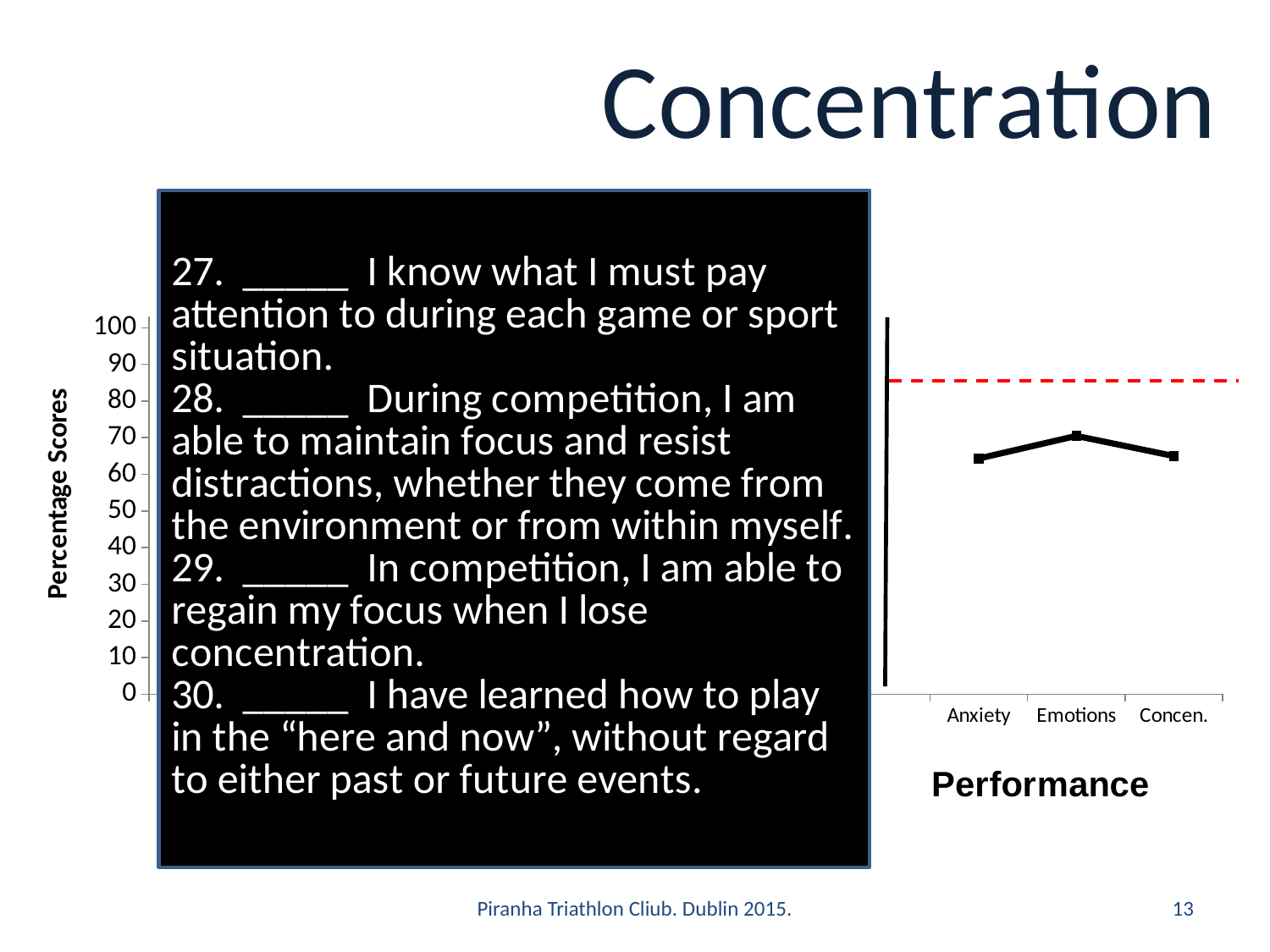
What kind of chart is shown on the slide? line chart Is the value for Emotions greater or less than 80? less Is the value for Emotions larger than the value for Anxiety? yes Does the line rise or fall from Emotions to Concen.? fall Which of the visible categories has the highest value? Emotions Is the value for Emotions greater or less than 60? greater What label appears below the category axis of the chart? Performance Is the value for Concen. larger than the value for Emotions? no Is the value for Concen. greater or less than 80? less What is the title of the vertical axis? Percentage Scores Does the line rise or fall from Anxiety to Emotions? rise